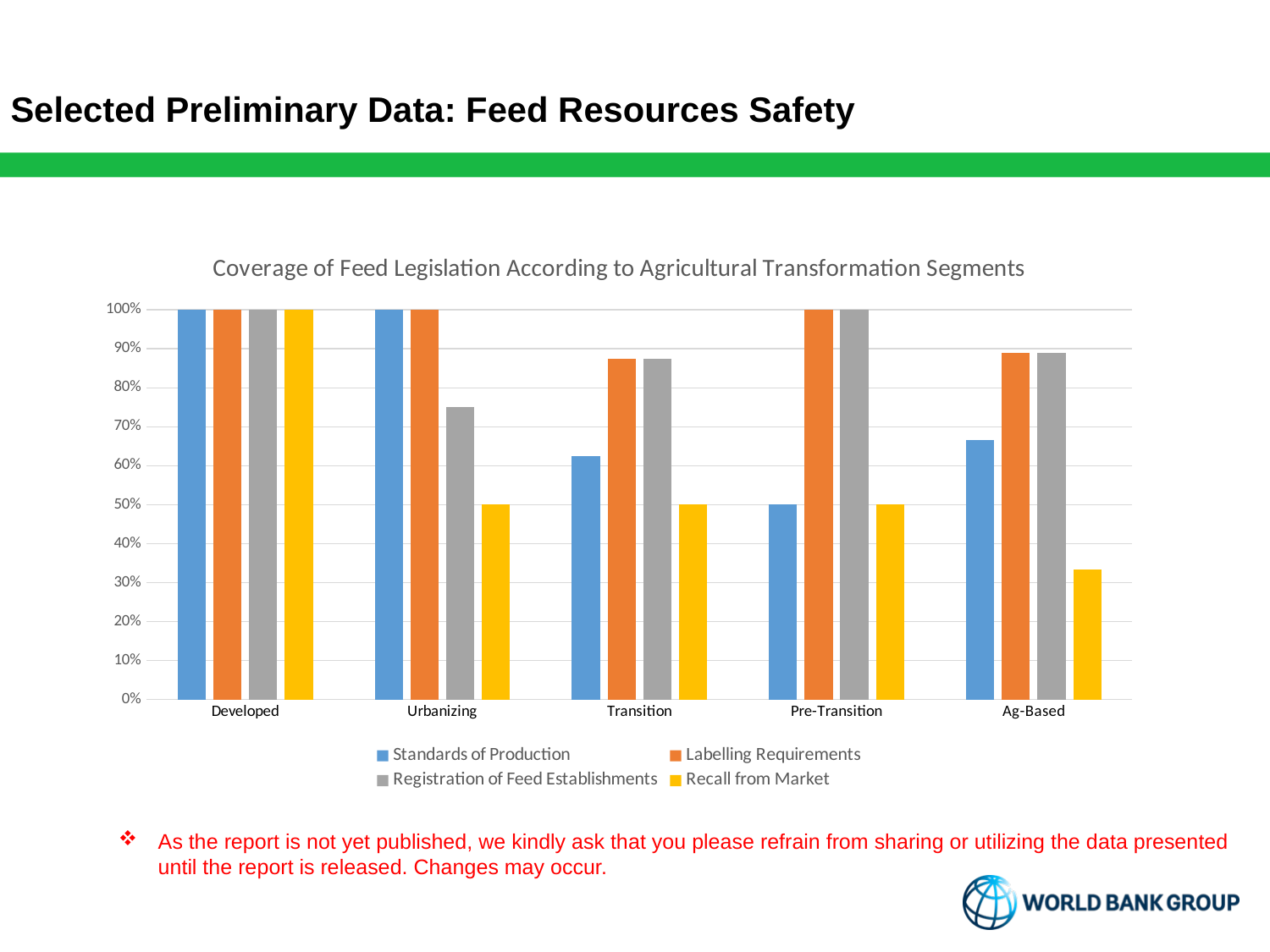
How many segment categories are shown on the x axis? 5 What is the value for Standards of Production in the Pre-Transition segment? 50% What is the value for Recall from Market in the Urbanizing segment? 50% What is the value for Recall from Market in the Developed segment? 100% Which segment has the lowest value for Recall from Market? Ag-Based What is the value for Labelling Requirements in the Pre-Transition segment? 100% How many series does the legend list? 4 What is the title of the chart? Coverage of Feed Legislation According to Agricultural Transformation Segments Is the value for Recall from Market in the Ag-Based segment greater or less than 40%? less Is the value for Registration of Feed Establishments in the Urbanizing segment greater or less than 70%? greater In the Transition segment, which is larger: Standards of Production or Labelling Requirements? Labelling Requirements What type of chart is shown on the slide? bar chart